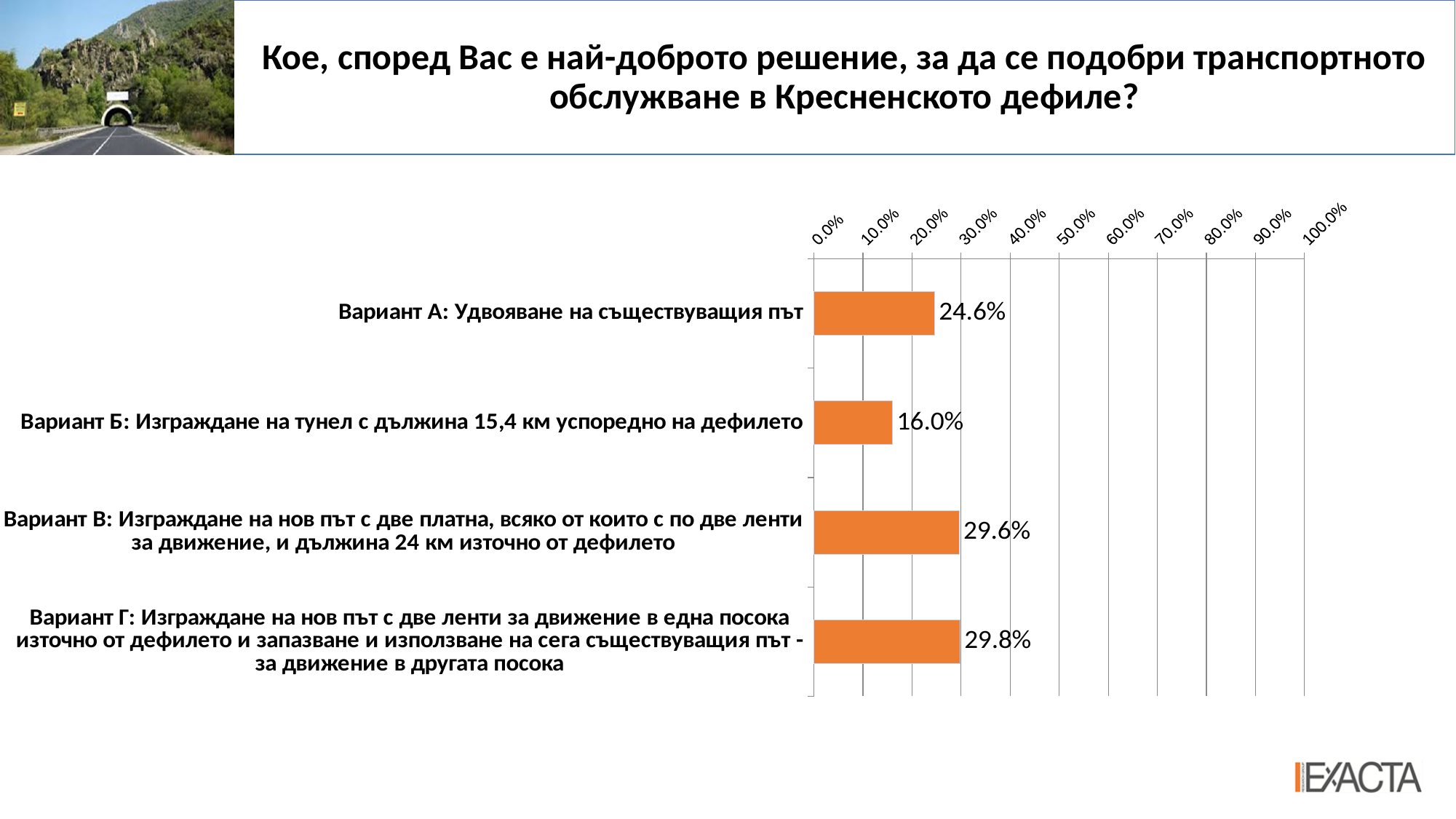
Which is larger, the value for Вариант А or the value for Вариант Б? Вариант А What is the value for Вариант А: Удвояване на съществуващия път? 24.6% What is the value for Вариант В (new road with two carriageways, 24 km east of the gorge)? 29.6% How many options (categories) are shown in the chart? 4 What is the value for Вариант Г (new two-lane one-way road east of the gorge, keeping the existing road for the other direction)? 29.8% What colour are the bars in the chart? Orange What kind of chart is shown on the slide? Bar chart What is the difference between the values for Вариант А and Вариант Б? 8.6% Is the value for Вариант В greater or less than 20.0%? greater Which option has the lowest value? Вариант Б What is the difference between the values for Вариант Г and Вариант В? 0.2% What is the value for Вариант Б: Изграждане на тунел с дължина 15,4 км успоредно на дефилето? 16.0%